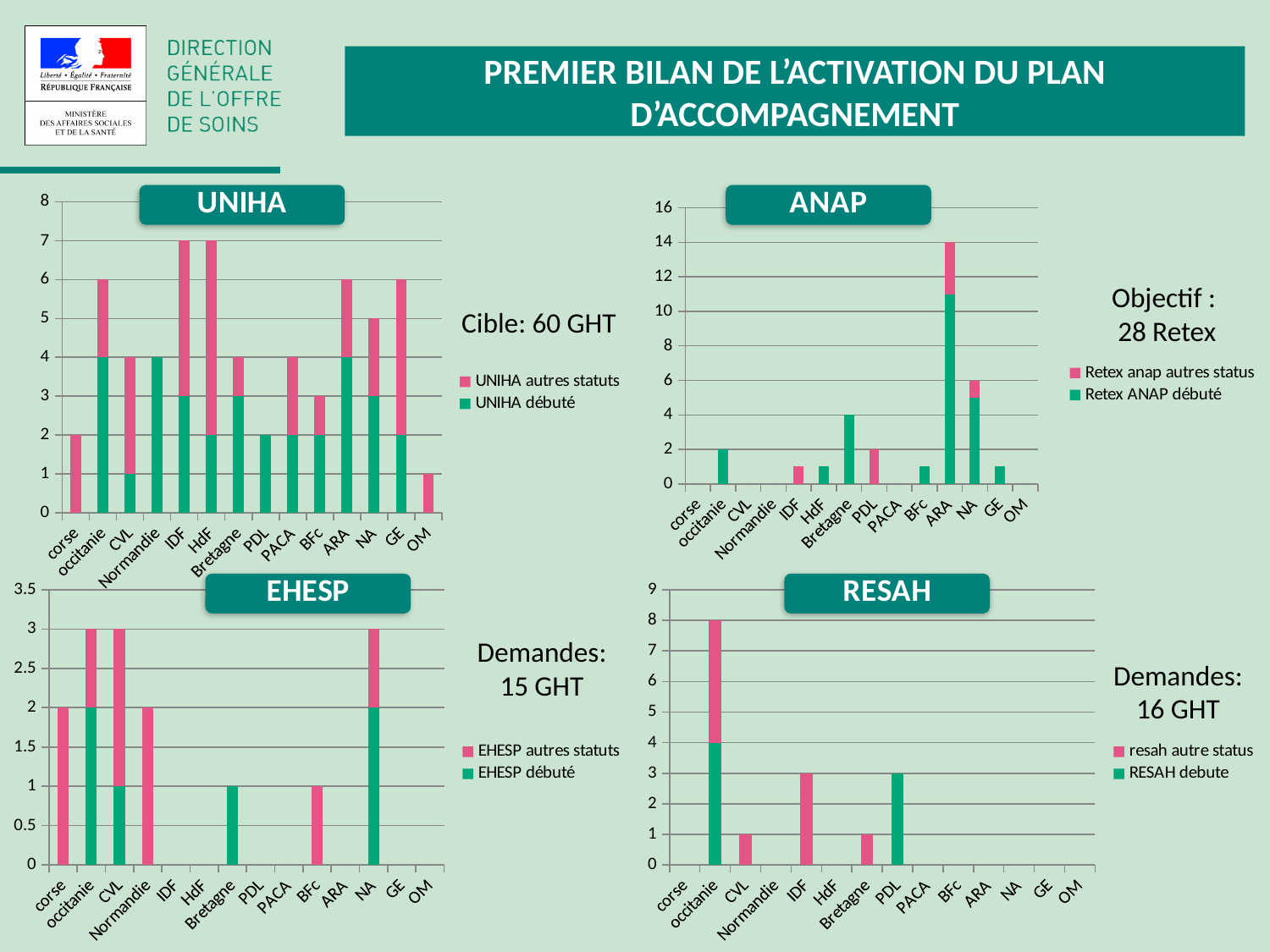
In the UNIHA chart, what is the total value of the bar for NA? 5 In the ANAP chart, what is the total value of the bar for ARA? 14 What type of chart is the ANAP chart? Stacked bar chart In the RESAH chart, what is the total value of the bar for occitanie? 8 In the ANAP chart, which region has the highest total bar? ARA In the UNIHA chart, which region has the lowest non-zero bar? OM How many regions are shown on the x axis of the UNIHA chart? 14 In the UNIHA chart, what is the difference between the total for IDF and the total for corse? 5 In the EHESP chart, which is larger, the bar for corse or the bar for occitanie? occitanie In the RESAH chart, which region has the tallest bar? occitanie How many series does the legend of the RESAH chart list? 2 In the ANAP chart, is the total bar for ARA greater or less than 10? greater